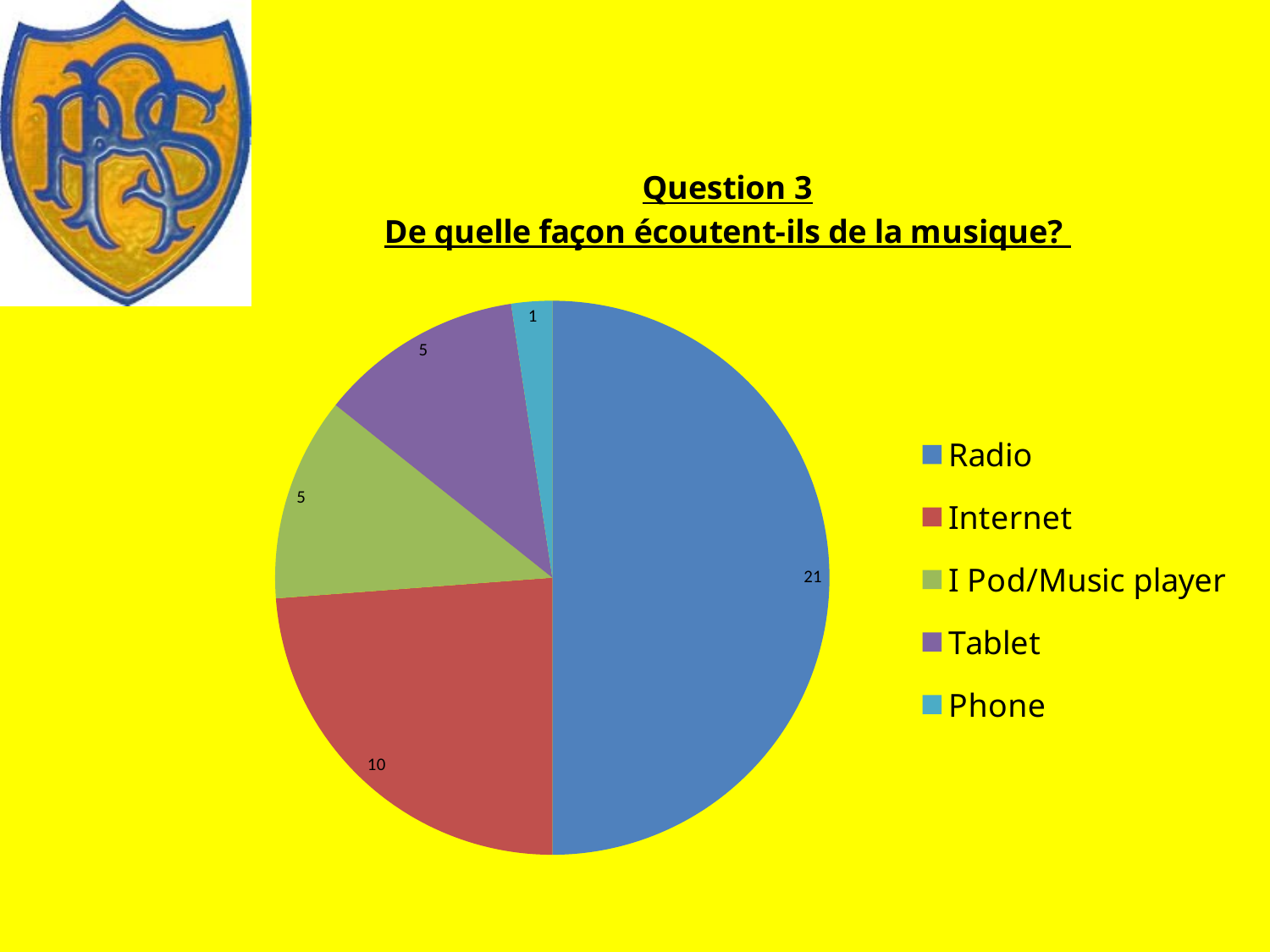
Which category has the smallest slice of the pie? Phone Which is larger, the value for Internet or the value for Tablet? Internet What is the value for Phone? 1 How many categories does the legend list? 5 What is the value for Radio? 21 What colour is the Radio slice? blue What share of the pie does Radio represent? 50% Which category has the largest slice of the pie? Radio What kind of chart is shown on the slide? pie chart What is the value for Tablet? 5 What is the difference between the values for Radio and Internet? 11 What is the value for Internet? 10